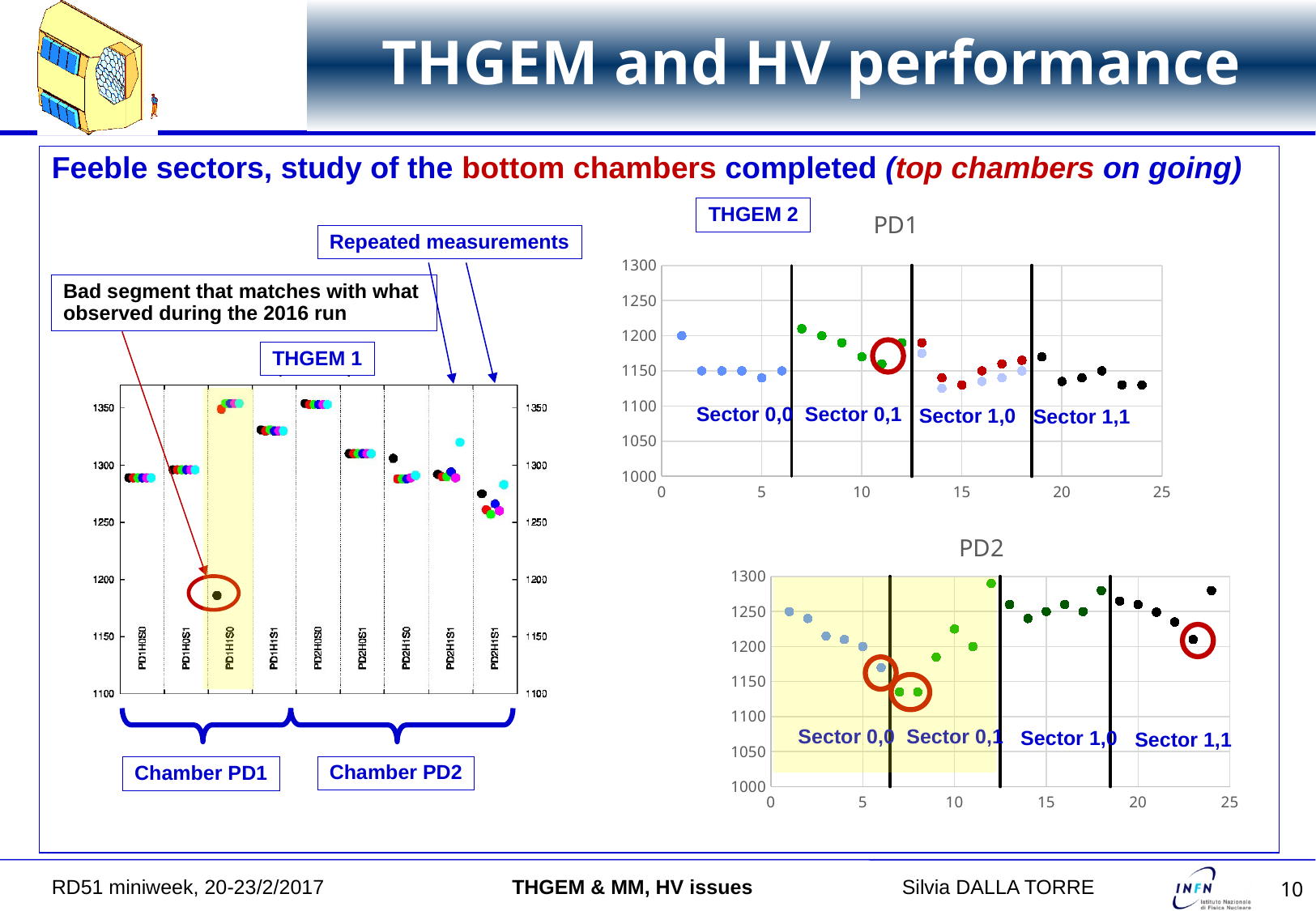
In the PD2 chart, do the values in Sector 0,0 rise or fall along the x axis? fall In the PD2 chart, which sector contains the lowest point? Sector 0,1 In the THGEM 1 chart on the left, is the circled point in PD1H1S0 greater or less than 1200? less What kind of chart is the PD1 chart on the right of the slide? scatter chart In the PD1 chart, how many sectors are labelled? 4 In the PD2 chart, are the values for Sector 1,0 greater or less than 1200? greater In the THGEM 1 chart on the left, which category contains the lowest point (the circled one)? PD1H1S0 In the PD2 chart, are the two circled points in Sector 0,1 greater or less than 1150? less What is the title of the bottom-right chart? PD2 In the PD1 chart, do the values in Sector 0,1 rise or fall along the x axis? fall